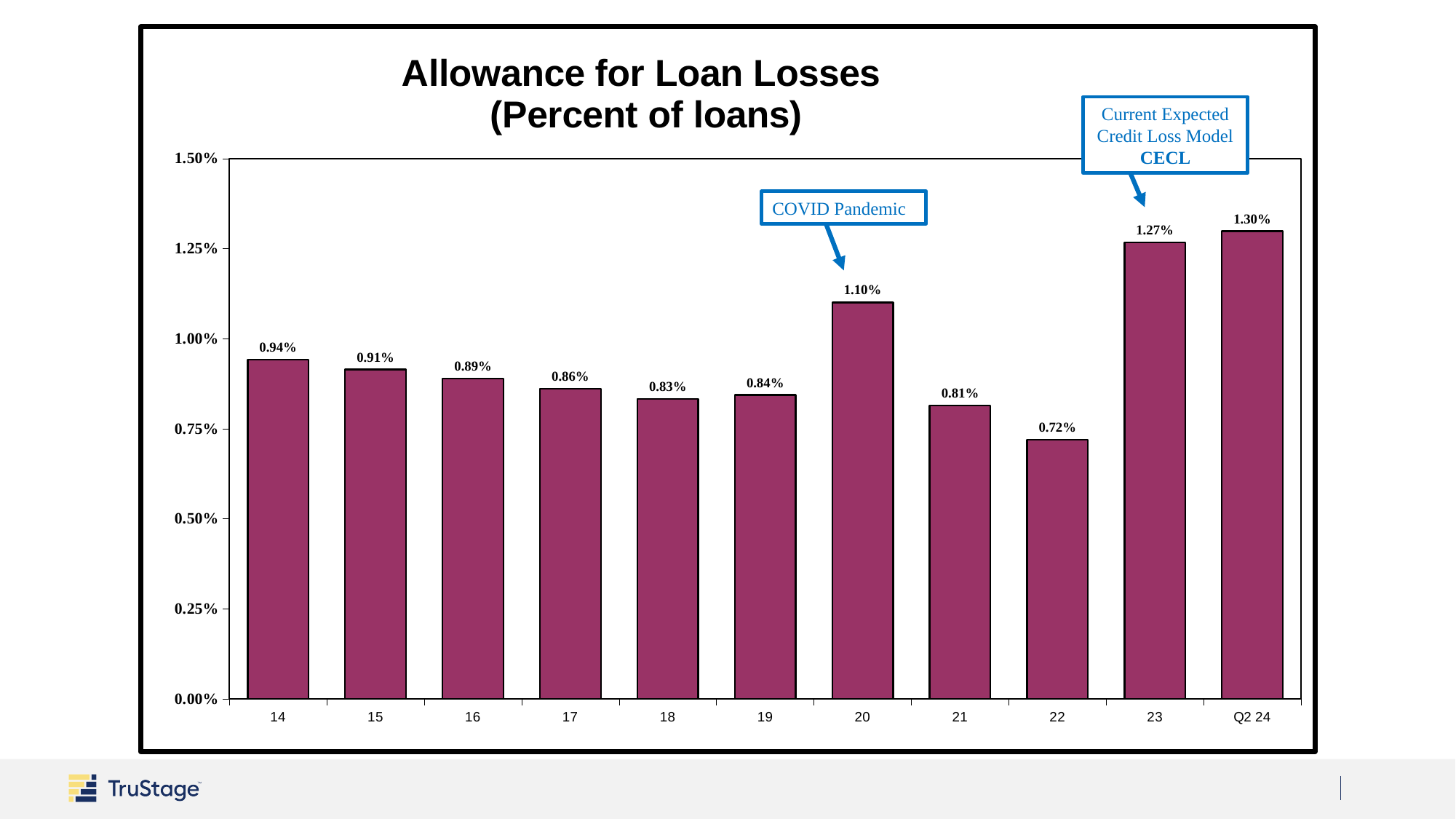
What is the value shown for Q2 24? 1.30% How many bars are shown in the chart? 11 What kind of chart is shown on the slide? bar chart Which event does the callout above the 20 bar label? COVID Pandemic Which year has the lowest allowance for loan losses? 22 Is the value for 21 greater or less than 1.00%? less Which category has the highest allowance for loan losses? Q2 24 What is the difference between the values for 23 and 22? 0.55% What is the value shown for 22? 0.72% Which is larger, the value for 14 or the value for 19? 14 What is the allowance for loan losses as a percent of loans in 20? 1.10% Do the values rise or fall from 14 to 18? fall